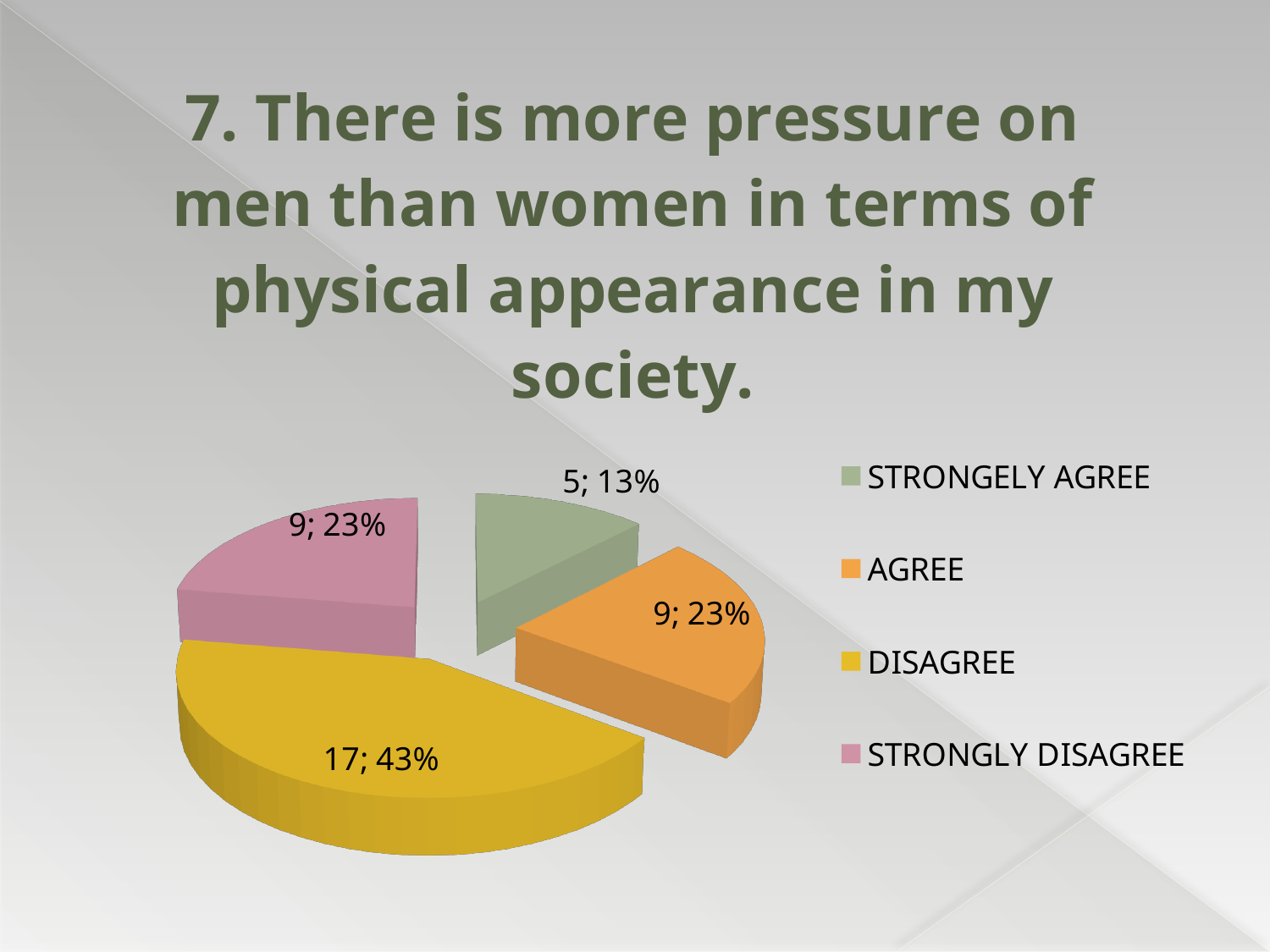
What is the count for STRONGLY AGREE? 5 What is the count for DISAGREE? 17 Which is larger, the count for DISAGREE or the count for STRONGLY DISAGREE? DISAGREE Which category has the smallest slice? STRONGLY AGREE What percentage share does AGREE have? 23% What percentage share does DISAGREE have? 43% What is the difference between the counts for DISAGREE and STRONGLY AGREE? 12 Which category has the largest slice? DISAGREE What colour is the DISAGREE slice? yellow What kind of chart is shown on the slide? pie chart How many slices does the pie chart have? 4 How many entries does the legend list? 4